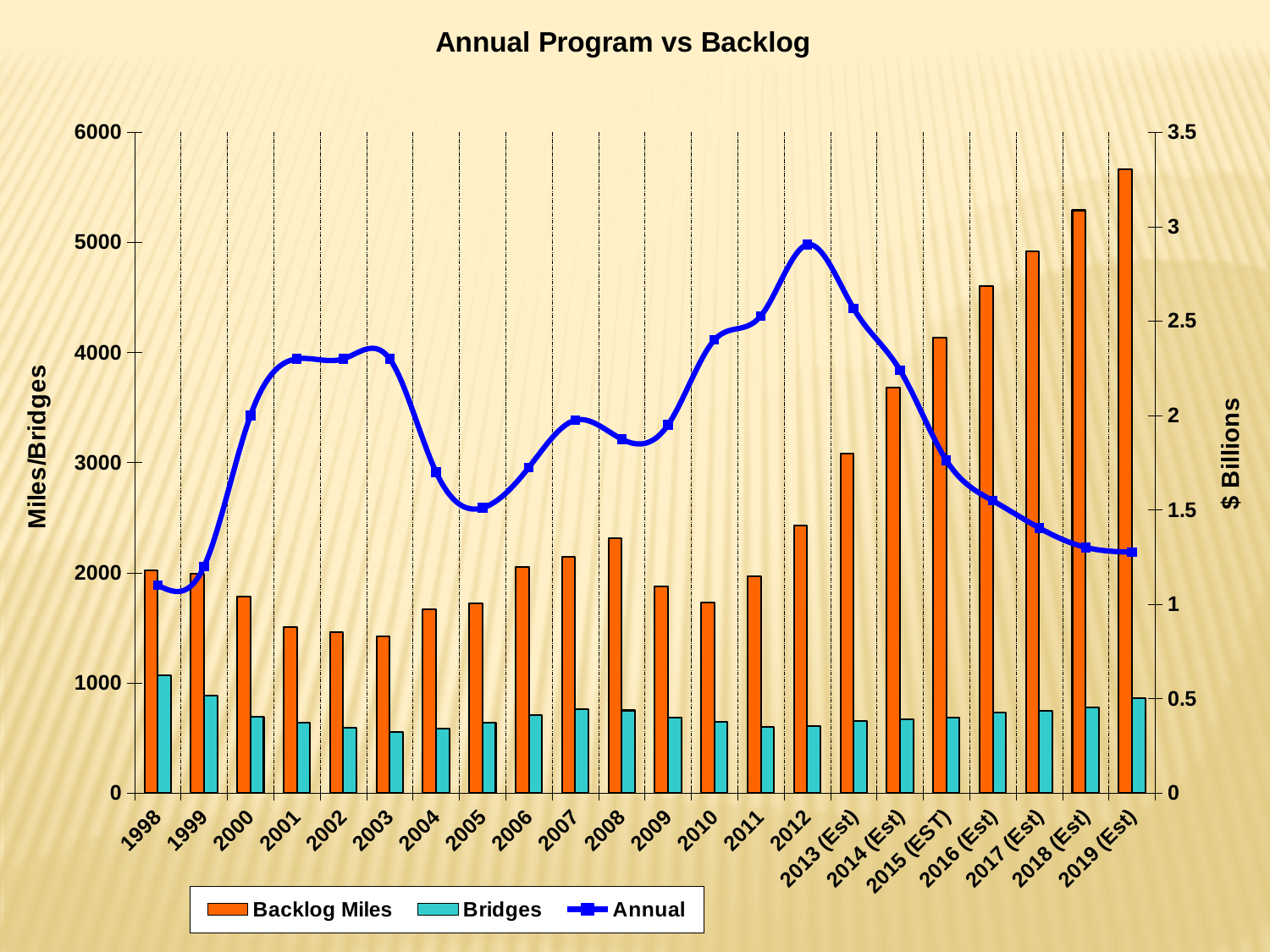
Is the Backlog Miles value for 2003 greater or less than 2000? less Is the Backlog Miles value for 2019 (Est) greater or less than 5000? greater Is the Annual value for 2005 greater or less than 2? less In which year does the Annual line reach its peak? 2012 Which year has the highest Bridges value? 1998 What kind of chart is shown on the slide? combination bar and line chart How many years (categories) are shown along the x axis? 22 How many series does the legend list? 3 Do the Backlog Miles values rise or fall from 2012 to 2019 (Est)? rise What is the label of the right-hand vertical axis? $ Billions Which year has the larger Backlog Miles value, 2012 or 2018 (Est)? 2018 (Est) Which year has the highest Backlog Miles value? 2019 (Est)